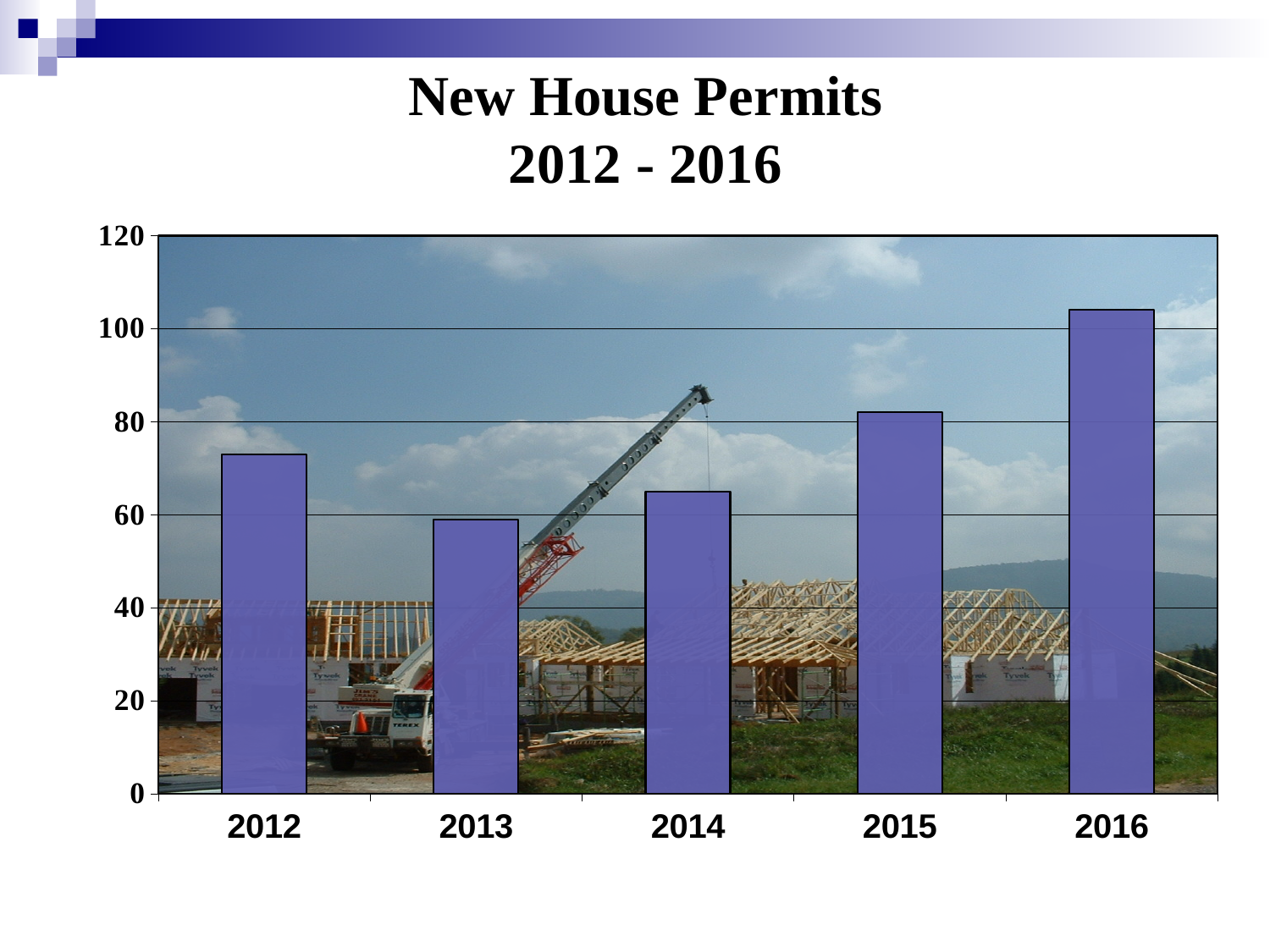
Is the value for 2012 greater or less than 60? greater Which year has the lowest number of new house permits? 2013 Is the value for 2015 greater or less than 100? less Which year has more new house permits, 2012 or 2013? 2012 What kind of chart is shown on the slide? bar chart What is the title of the chart? New House Permits 2012 - 2016 Is the value for 2014 greater or less than 80? less Which year has more new house permits, 2014 or 2015? 2015 Which year has the highest number of new house permits? 2016 Do the values rise or fall from 2013 to 2016? rise How many years are shown on the x axis of the chart? 5